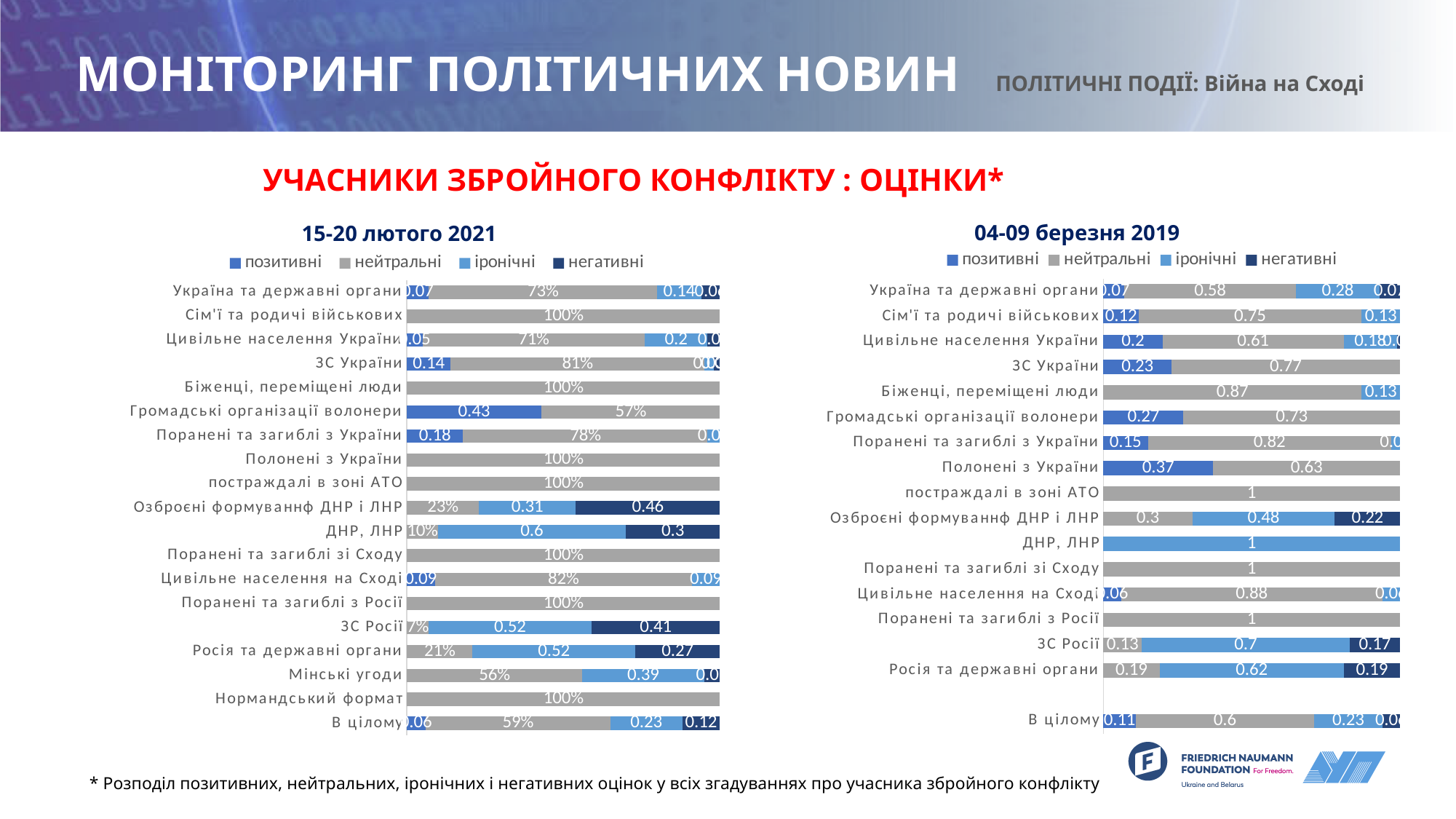
In the chart titled "04-09 березня 2019", what is the нейтральні value for Біженці, переміщені люди? 0.87 In the chart titled "04-09 березня 2019", what is the іронічні value for ЗС Росії? 0.7 In the chart titled "15-20 лютого 2021", what is the негативні value for Озброєні формуваннф ДНР і ЛНР? 0.46 In the chart titled "15-20 лютого 2021", which has the larger позитивні value: Громадські організації волонери or Поранені та загиблі з України? Громадські організації волонери How many categories are shown in the chart titled "04-09 березня 2019"? 17 How many series does the legend of the chart titled "15-20 лютого 2021" list? 4 In the chart titled "15-20 лютого 2021", what is the іронічні value for Мінські угоди? 0.39 What kind of chart is the chart titled "04-09 березня 2019"? stacked bar chart In the chart titled "15-20 лютого 2021", what is the нейтральні value for Громадські організації волонери? 57% In the chart titled "04-09 березня 2019", what is the difference between the нейтральні values for ЗС України and Полонені з України? 0.14 In the chart titled "04-09 березня 2019", what is the позитивні value for Полонені з України? 0.37 How many categories are shown in the chart titled "15-20 лютого 2021"? 19